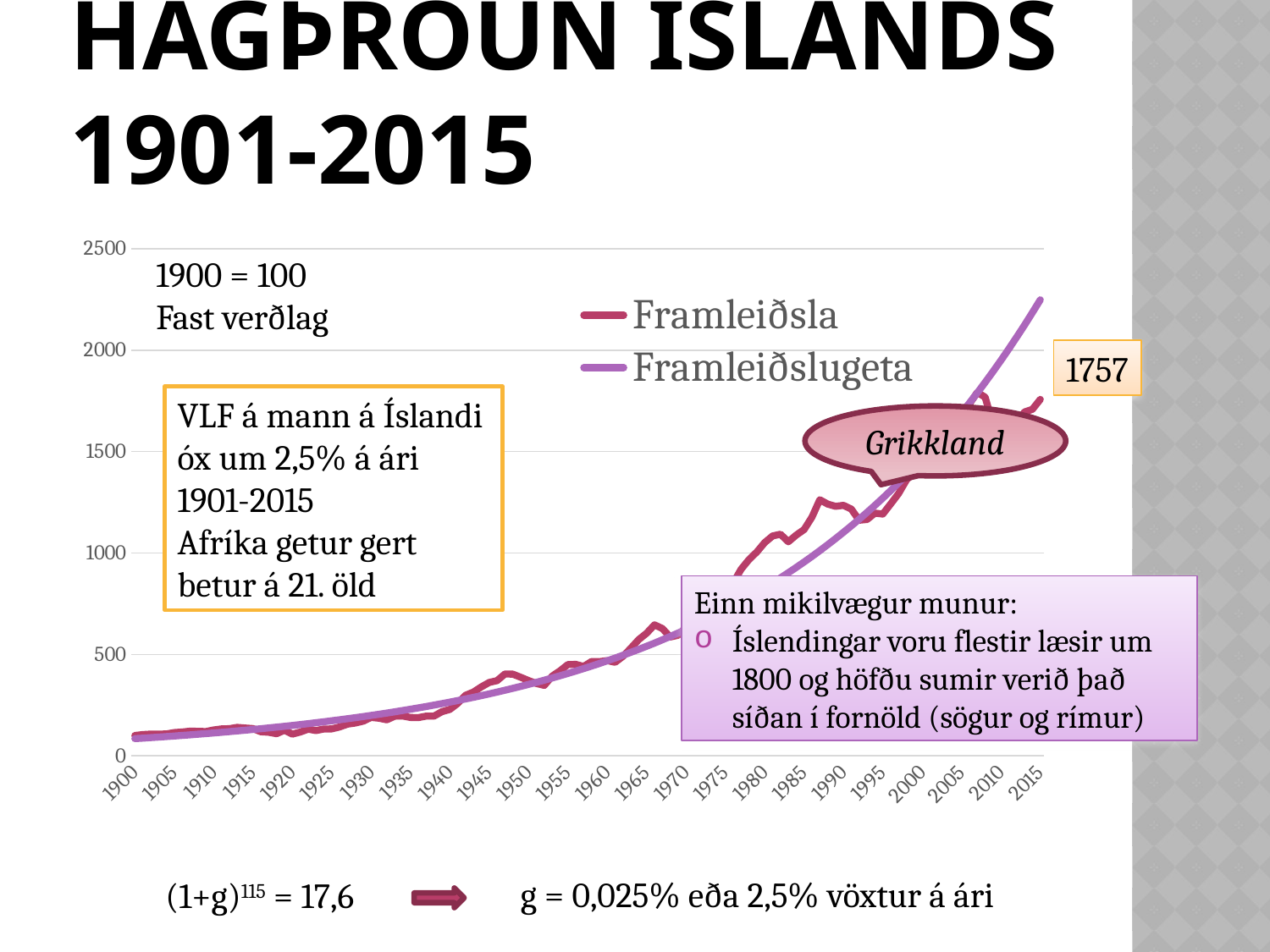
What kind of chart is shown on the slide? line chart What value is printed as the data label at the end of the Framleiðsla line in 2015? 1757 Is the value of Framleiðslugeta in 1900 greater or less than 500? less What is the highest value shown on the y axis? 2500 What are the two series named in the chart legend? Framleiðsla and Framleiðslugeta Is the value of Framleiðsla in 1985 greater or less than 1000? greater In 2015, which series has the higher value, Framleiðsla or Framleiðslugeta? Framleiðslugeta How many year labels are shown on the x axis? 24 Do the values of the Framleiðsla series generally rise or fall from 1900 to 2015? rise How many series does the chart legend list? 2 Is the value of Framleiðsla in 1950 greater or less than 500? less